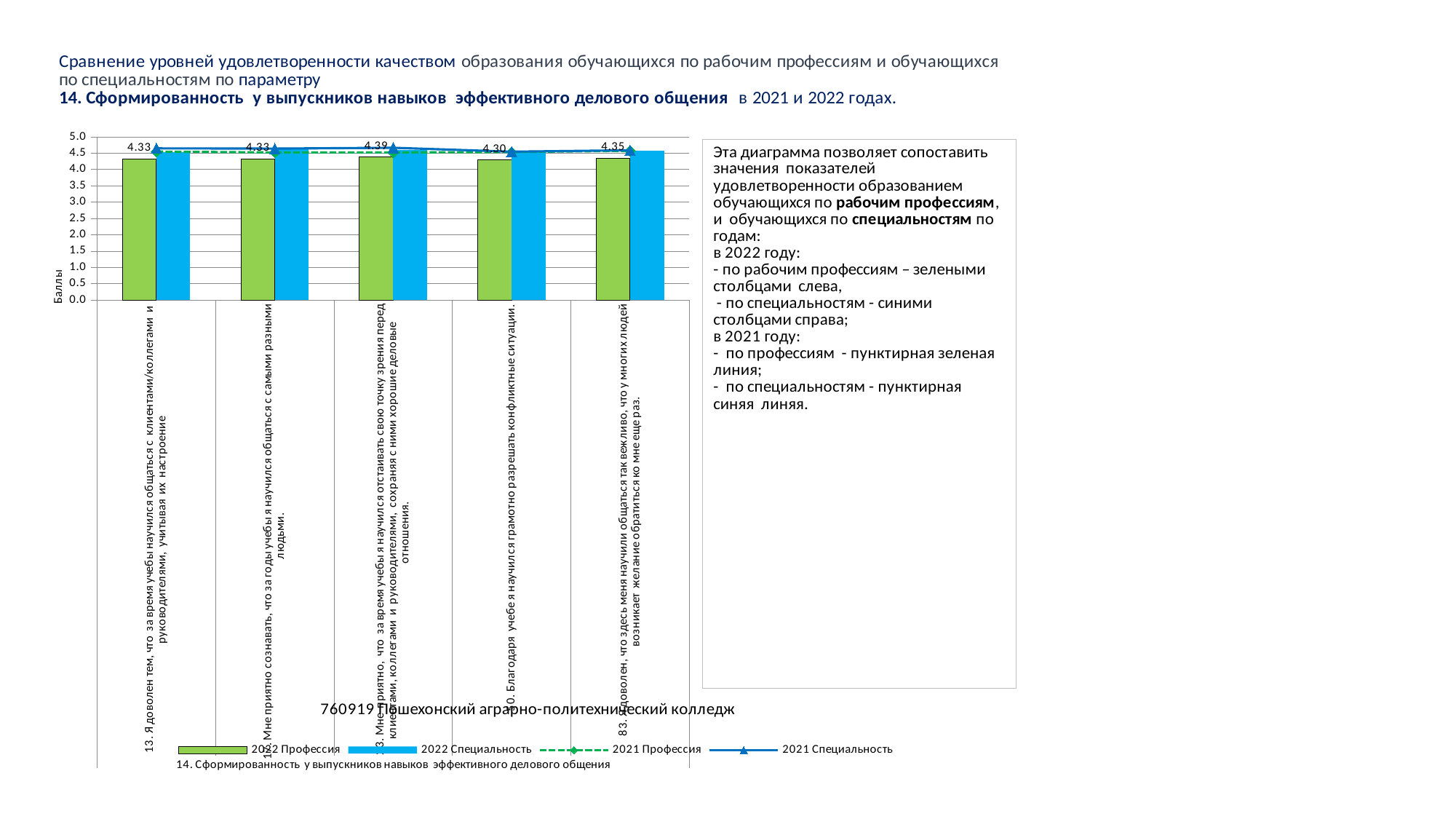
What kind of chart is shown on the slide? Bar chart (with two line series overlaid) For the 2022 Профессия series, which is larger: the value for category 13 or the value for category 83? Category 83 (4.35) What is the value of the 2022 Профессия series for the fourth category ("Благодаря учебе я научился грамотно разрешать конфликтные ситуации")? 4.30 What is the value of the 2022 Профессия series for the category "83. Я доволен, что здесь меня научили общаться так вежливо, что у многих людей возникает желание обратиться ко мне еще раз"? 4.35 What is the value of the 2022 Профессия series for the category "13. Я доволен тем, что за время учебы научился общаться с клиентами/коллегами и руководителями, учитывая их настроение"? 4.33 How many categories are shown on the x axis of the chart? 5 What is the title of the vertical axis of the chart? Баллы How many series does the chart legend list? 4 Which category has the lowest labelled value for the 2022 Профессия series? The fourth category ("Благодаря учебе я научился грамотно разрешать конфликтные ситуации"), 4.30 What is the difference between the highest (4.39) and lowest (4.30) labelled values of the 2022 Профессия series? 0.09 Which category has the highest labelled value for the 2022 Профессия series? The third category ("Мне приятно, что за время учебы я научился отстаивать свою точку зрения перед клиентами, коллегами и руководителями..."), 4.39 Is the 2022 Специальность value for category 13 greater or less than 4.0? greater